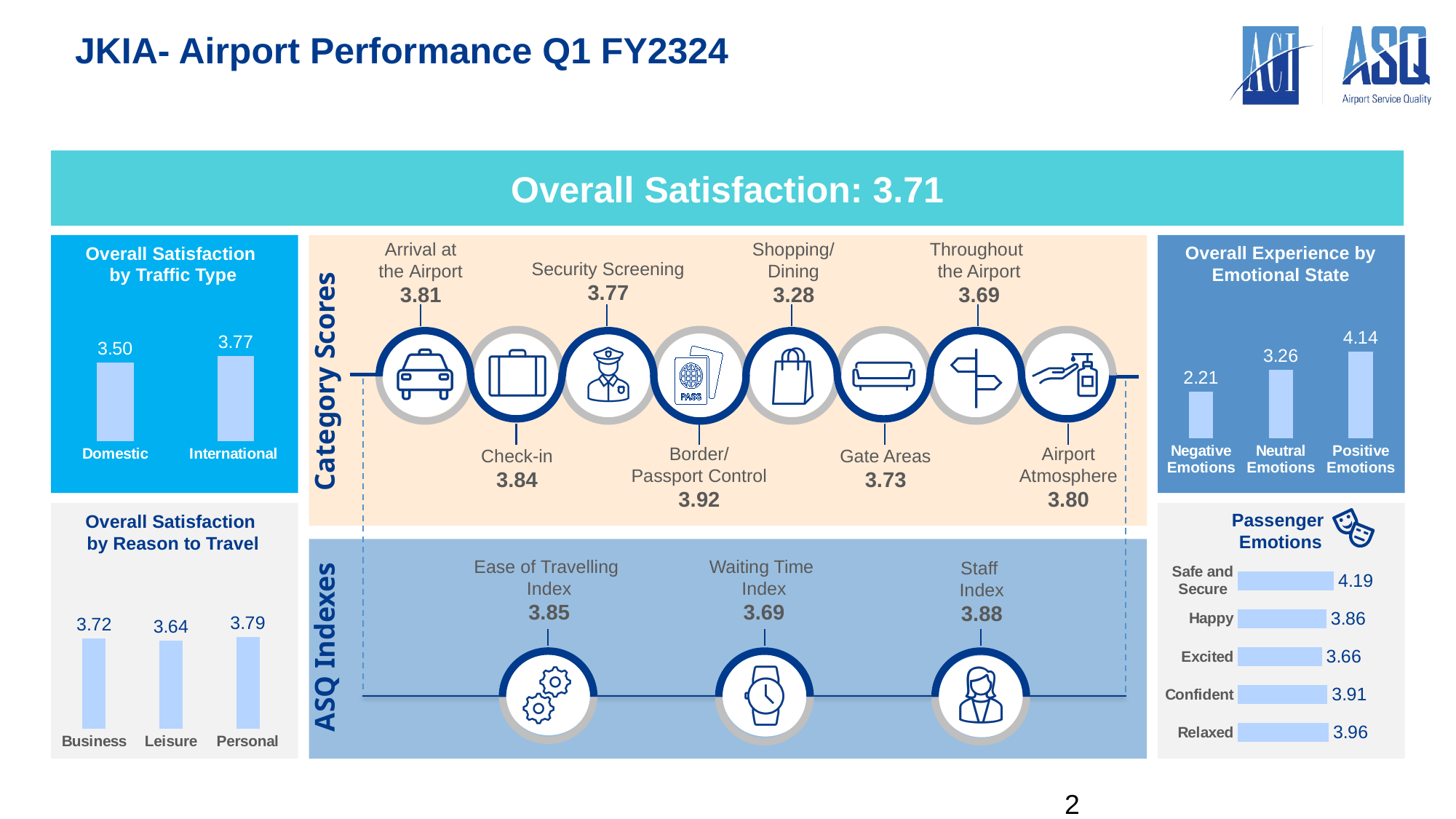
In the 'Passenger Emotions' chart, which emotion has the lowest value? Excited In the 'Overall Satisfaction by Traffic Type' chart, what is the difference between the International and Domestic values? 0.27 In the 'Passenger Emotions' chart, which is larger, the value for Confident or the value for Happy? Confident In the 'Overall Experience by Emotional State' chart, what is the value for Negative Emotions? 2.21 In the 'Overall Satisfaction by Reason to Travel' chart, which category has the lowest value? Leisure In the 'Overall Satisfaction by Reason to Travel' chart, which category has the highest value? Personal In the 'Overall Experience by Emotional State' chart, what is the difference between Positive Emotions and Neutral Emotions? 0.88 What kind of chart is the 'Passenger Emotions' chart? Bar chart How many categories are shown in the 'Overall Satisfaction by Reason to Travel' chart? 3 In the 'Overall Satisfaction by Traffic Type' chart, what is the value for International? 3.77 In the 'Passenger Emotions' chart, which emotion has the highest value? Safe and Secure In the 'Overall Satisfaction by Reason to Travel' chart, what is the value for Business? 3.72